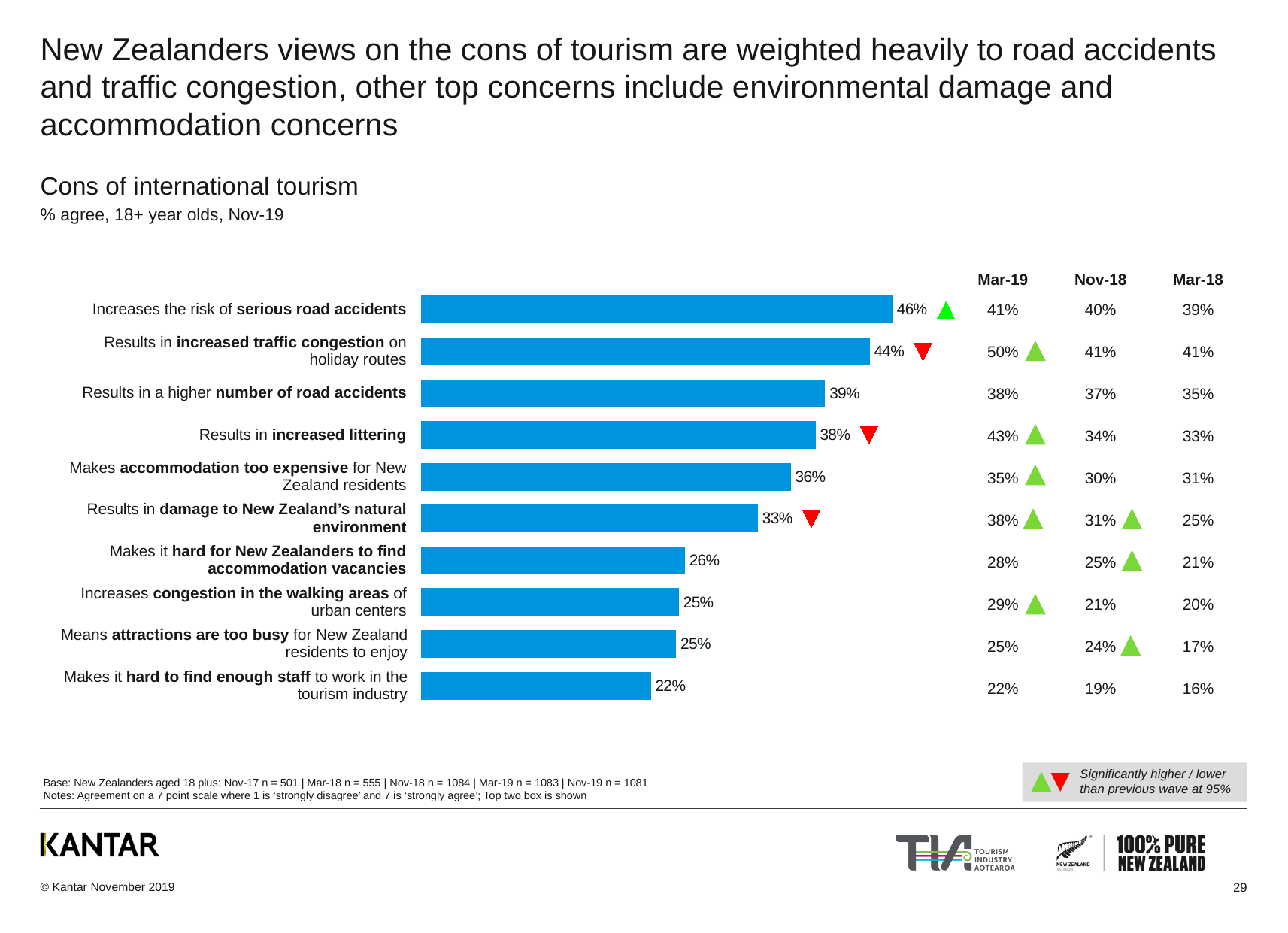
What percentage of New Zealanders agree that international tourism increases the risk of serious road accidents (Nov-19)? 46% What is the difference between 'Results in increased littering' and 'Makes it hard to find enough staff to work in the tourism industry'? 16 percentage points What is the Nov-19 value for 'Makes it hard to find enough staff to work in the tourism industry'? 22% How many percentage points higher is 'Increases the risk of serious road accidents' than 'Results in increased traffic congestion on holiday routes'? 2 percentage points Which con of international tourism has the highest level of agreement in the bar chart? Increases the risk of serious road accidents According to the table beside the chart, what was the Mar-19 value for 'Results in increased traffic congestion on holiday routes'? 50% What is the Nov-19 value for 'Results in damage to New Zealand's natural environment'? 33% What is the title of the chart on the slide? Cons of international tourism Which con of international tourism has the lowest level of agreement in the bar chart? Makes it hard to find enough staff to work in the tourism industry How many cons of international tourism are shown in the bar chart? 10 Which has a higher value: 'Results in increased littering' or 'Makes accommodation too expensive for New Zealand residents'? Results in increased littering What type of chart is used to show the cons of international tourism? Bar chart